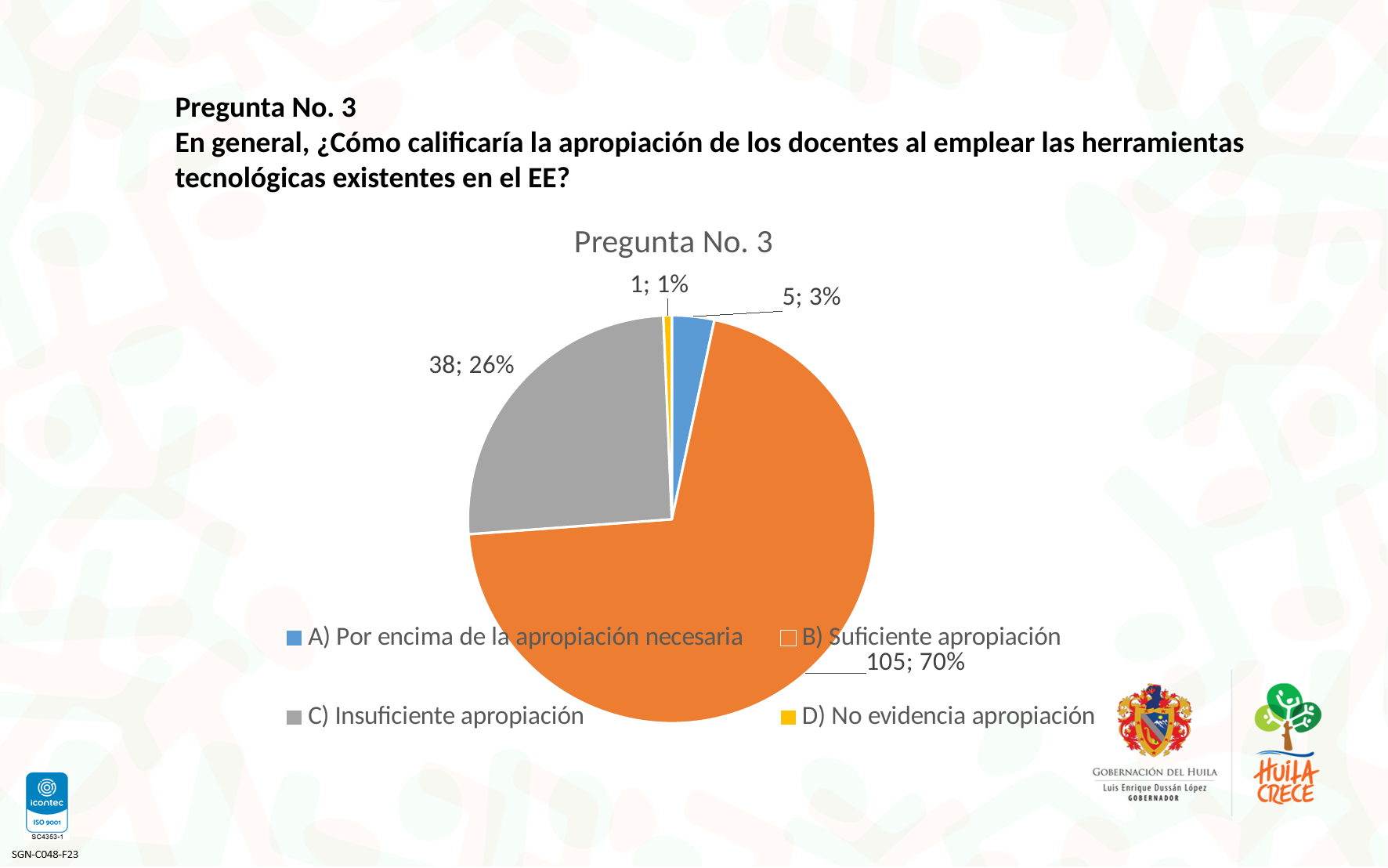
What is the count for B) Suficiente apropiación? 105 How many slices does the pie chart have? 4 Which category has the smallest slice? D) No evidencia apropiación What share of the pie does C) Insuficiente apropiación represent? 26% How many entries does the legend list? 4 What is the count for C) Insuficiente apropiación? 38 What is the count for D) No evidencia apropiación? 1 What type of chart is shown on the slide? pie chart Which category has the largest slice? B) Suficiente apropiación What is the difference between the counts for B) Suficiente apropiación and C) Insuficiente apropiación? 67 What is the count for A) Por encima de la apropiación necesaria? 5 What is the title of the chart? Pregunta No. 3